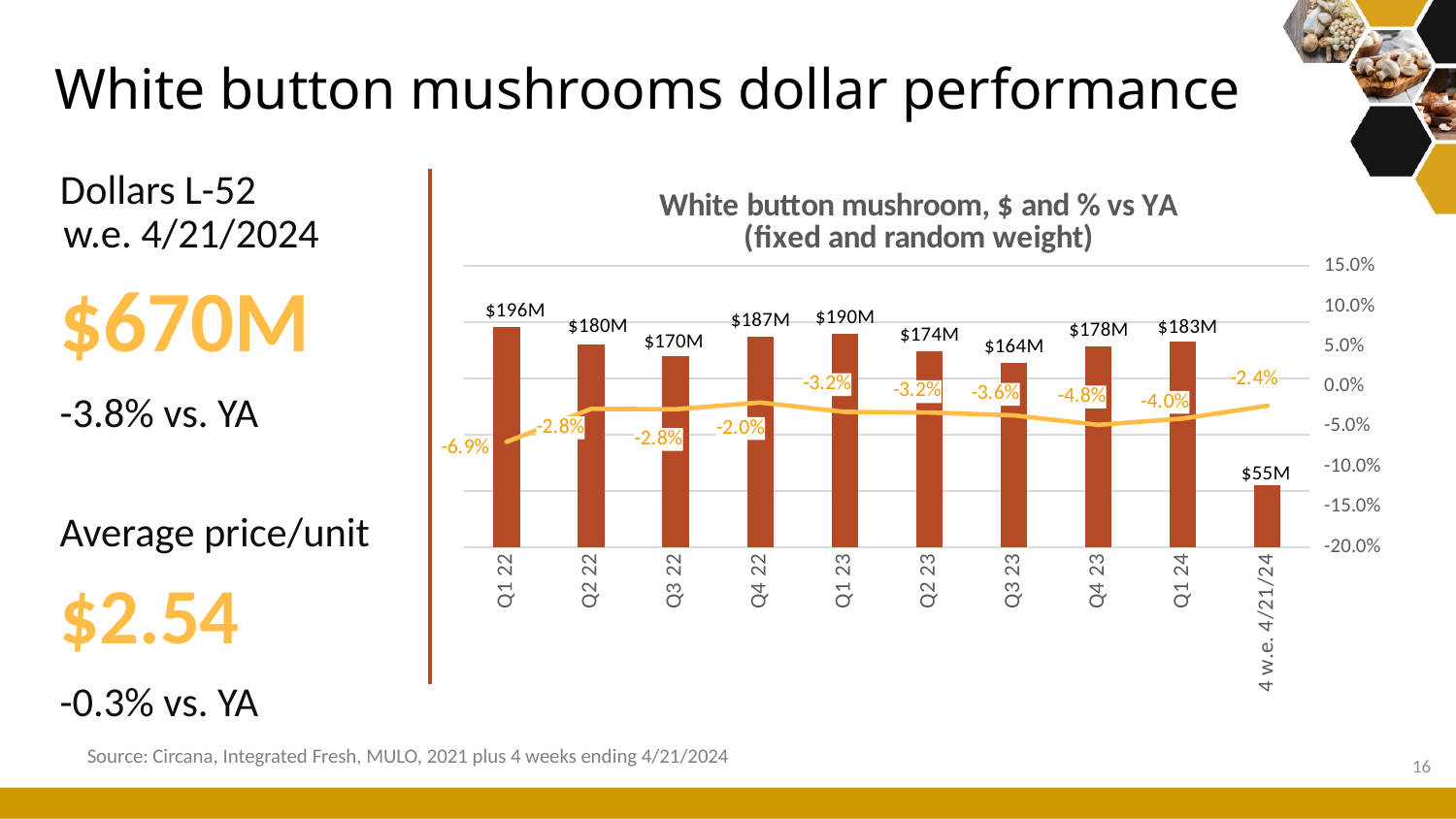
How many periods are shown on the x axis? 10 Which quarter has the highest dollar value? Q1 22 What is the difference in dollar value between Q1 23 and Q3 23? $26M What is the % vs YA value shown for Q4 23? -4.8% Which is larger, the dollar value for Q4 22 or for Q1 24? Q4 22 What kind of chart is this? Combined bar and line chart What is the dollar value shown for the 4 w.e. 4/21/24 period? $55M What is the dollar value shown for Q1 22? $196M Which period has the lowest dollar value? 4 w.e. 4/21/24 What is the % vs YA value shown for Q4 22? -2.0% What is the title of the chart? White button mushroom, $ and % vs YA (fixed and random weight) Which period has the lowest % vs YA value? Q1 22